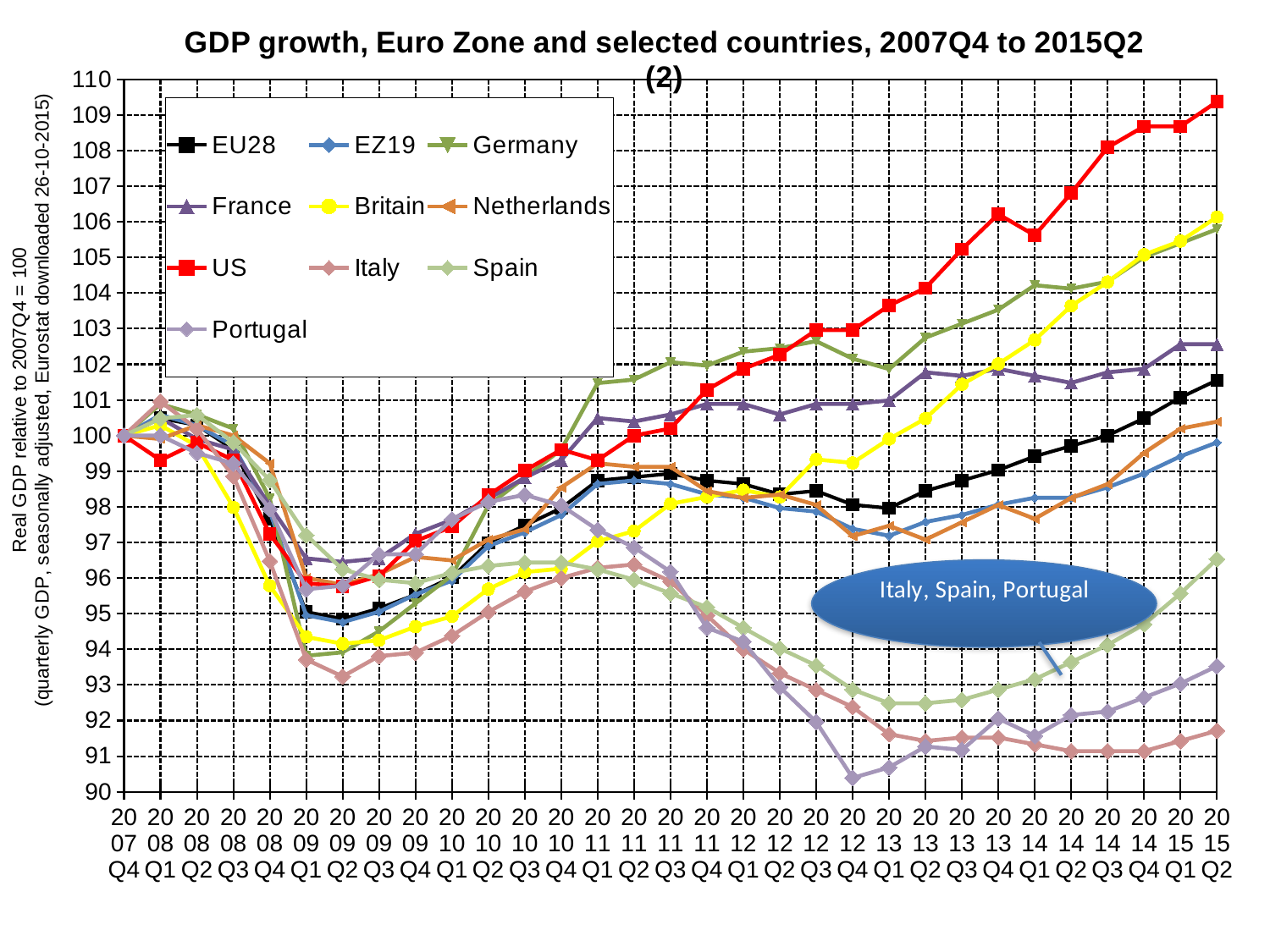
Is the value for Portugal in 2012Q4 greater or less than 91? less What is the value for EU28 in 2007Q4? 100 What is the title of the chart? GDP growth, Euro Zone and selected countries, 2007Q4 to 2015Q2 (2) Which series has the lowest value in 2015Q2? Italy In 2015Q2, which is larger, the value for Spain or the value for Italy? Spain Is the value for the US in 2015Q2 greater or less than 108? greater Does the US series rise or fall from 2009Q2 to 2015Q2? rise How many series does the legend list? 10 Which series has the highest value in 2015Q2? US How many quarterly points are plotted along the x axis? 31 Is the value for Italy in 2015Q2 greater or less than 93? less What kind of chart is shown on the slide? line chart